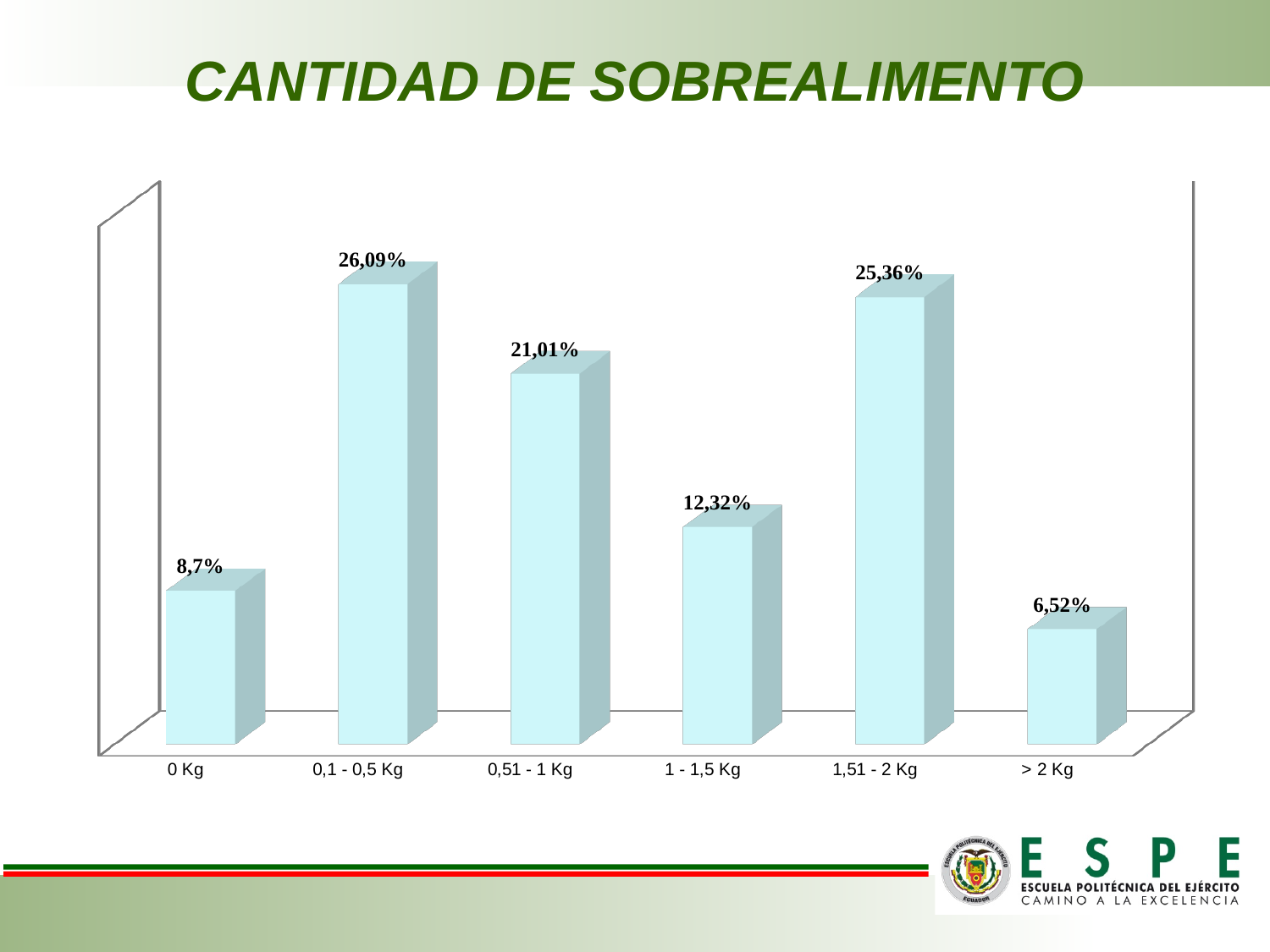
Which is larger, the value for 0,51 - 1 Kg or the value for 1 - 1,5 Kg? 0,51 - 1 Kg How many categories are shown on the chart? 6 What is the value for the 0 Kg category? 8,7% What is the value for the 1,51 - 2 Kg category? 25,36% Which category has the highest value? 0,1 - 0,5 Kg What is the title of the slide? CANTIDAD DE SOBREALIMENTO What is the difference between the values for 0,51 - 1 Kg and 1 - 1,5 Kg? 8,69% What kind of chart is shown on the slide? Bar chart What is the value for the > 2 Kg category? 6,52% What is the difference between the values for 0 Kg and > 2 Kg? 2,18% Which category has the lowest value? > 2 Kg What is the value for the 0,1 - 0,5 Kg category? 26,09%